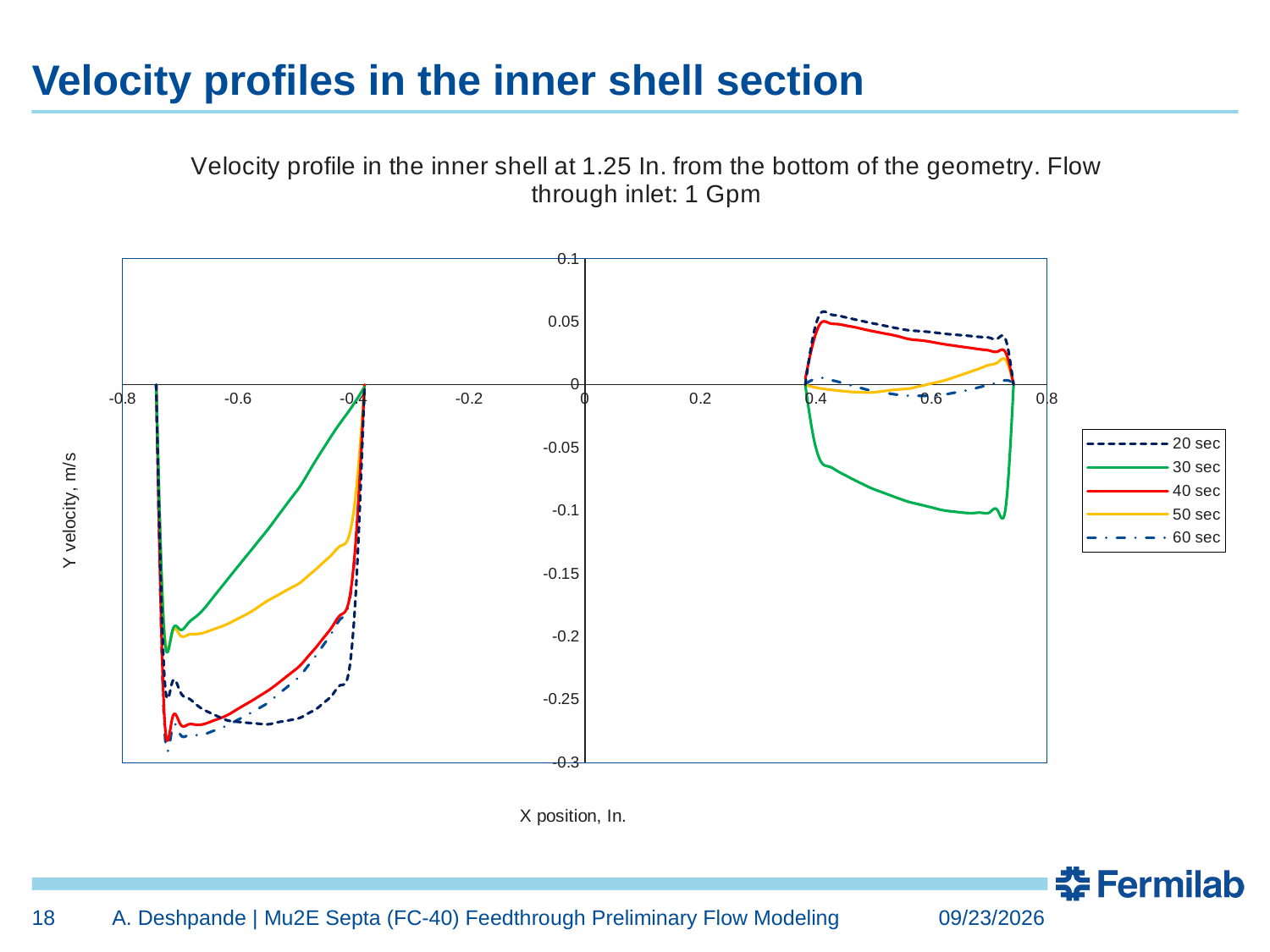
Which series reaches the highest Y velocity on the right-hand side of the chart (X position between 0.4 and 0.8)? 20 sec Is the maximum Y velocity of the 30 sec series on the right-hand side of the chart greater or less than 0.05? less Which series reaches the lowest Y velocity on the right-hand side of the chart (X position between 0.4 and 0.8)? 30 sec Is the minimum Y velocity of the 50 sec series on the left-hand side of the chart greater or less than -0.25? greater Which colour is used for the 30 sec series? green On the right-hand side of the chart around X position 0.6, which series has the higher Y velocity: 40 sec or 30 sec? 40 sec How many series does the legend list? 5 Is the minimum Y velocity of the 40 sec series on the left-hand side of the chart greater or less than -0.25? less What is the title of the chart? Velocity profile in the inner shell at 1.25 In. from the bottom of the geometry. Flow through inlet: 1 Gpm On the left-hand side of the chart, which series has the least negative Y velocity around X position -0.6: 30 sec or 50 sec? 30 sec What kind of chart is shown on the slide? line chart